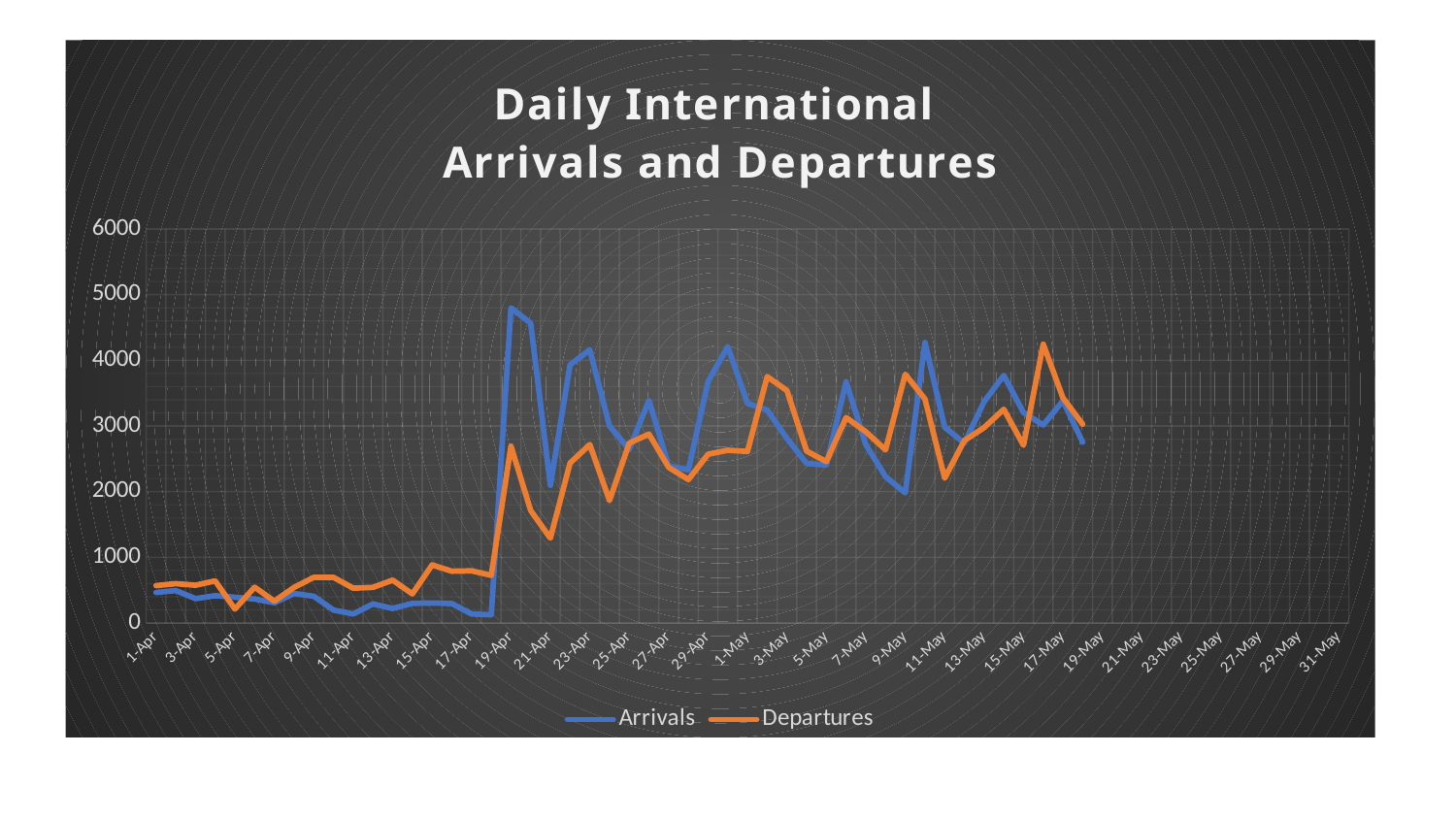
Is the value for Arrivals on 1-Apr greater or less than 1000? less Which colour is used for the Departures line? orange What kind of chart is shown on the slide? line chart Is the value for Departures on 17-May greater or less than 4000? less Is the value for Arrivals on 19-Apr greater or less than 4000? greater On which date does the Arrivals line reach its highest value? 19-Apr How many series does the legend list? 2 On 19-Apr, which series has the larger value, Arrivals or Departures? Arrivals What is the title of the chart? Daily International Arrivals and Departures Do the Arrivals values rise or fall between 17-Apr and 19-Apr? rise